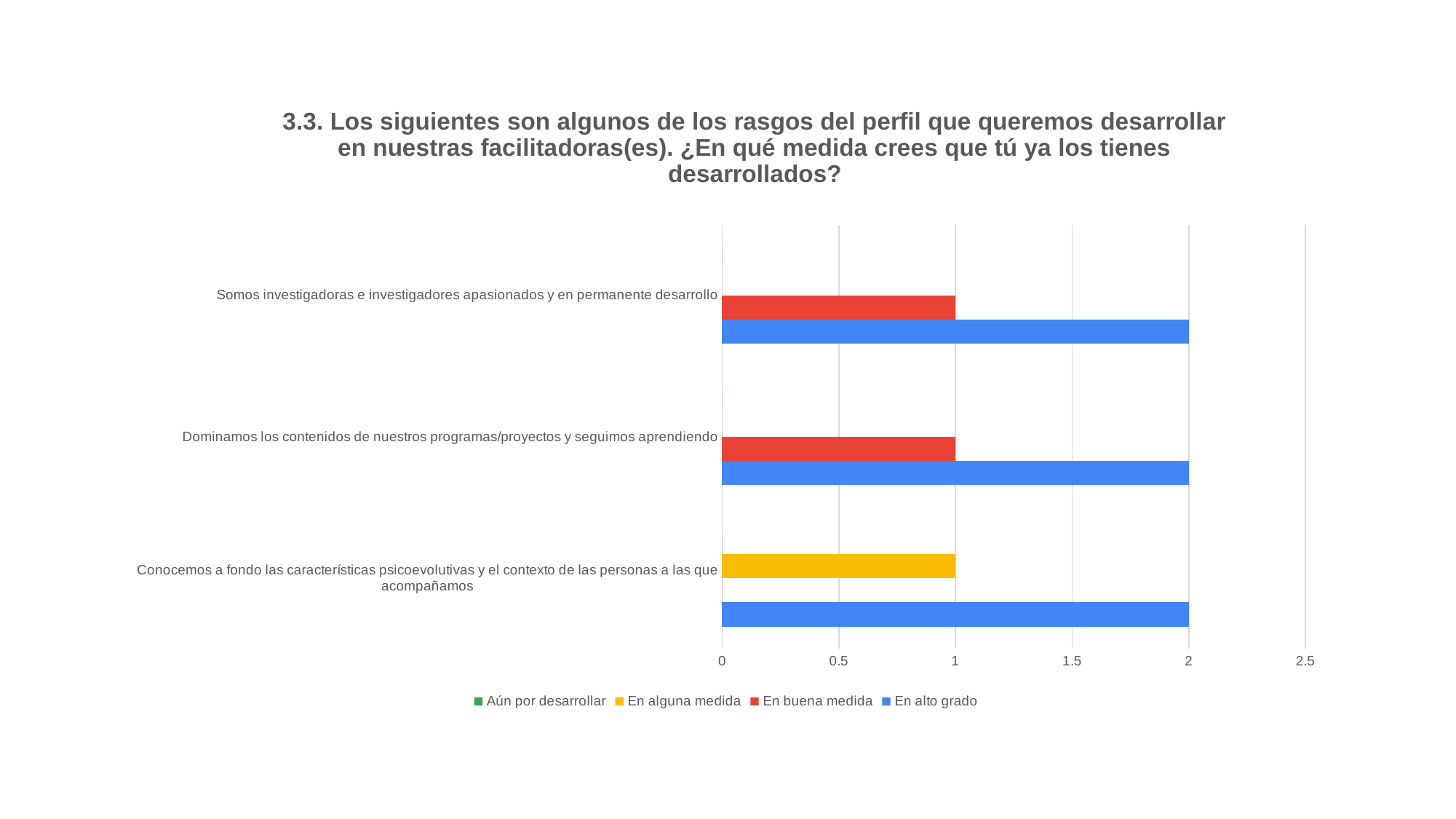
What is the value of "En buena medida" for "Dominamos los contenidos de nuestros programas/proyectos y seguimos aprendiendo"? 1 Which colour represents the "En alto grado" series in the legend? blue For "Conocemos a fondo las características psicoevolutivas y el contexto de las personas a las que acompañamos", which is larger: "En alguna medida" or "En alto grado"? En alto grado What is the value of "En alguna medida" for "Conocemos a fondo las características psicoevolutivas y el contexto de las personas a las que acompañamos"? 1 Which series has the highest value for "Dominamos los contenidos de nuestros programas/proyectos y seguimos aprendiendo"? En alto grado What is the difference between "En alto grado" and "En buena medida" for "Somos investigadoras e investigadores apasionados y en permanente desarrollo"? 1 What is the value of "En alto grado" for "Somos investigadoras e investigadores apasionados y en permanente desarrollo"? 2 Is the value of "En alto grado" for "Dominamos los contenidos de nuestros programas/proyectos y seguimos aprendiendo" greater or less than 1.5? greater How many categories are plotted on the chart? 3 How many series does the legend list? 4 What is the value of "En alto grado" for "Conocemos a fondo las características psicoevolutivas y el contexto de las personas a las que acompañamos"? 2 What kind of chart is shown on the slide? bar chart